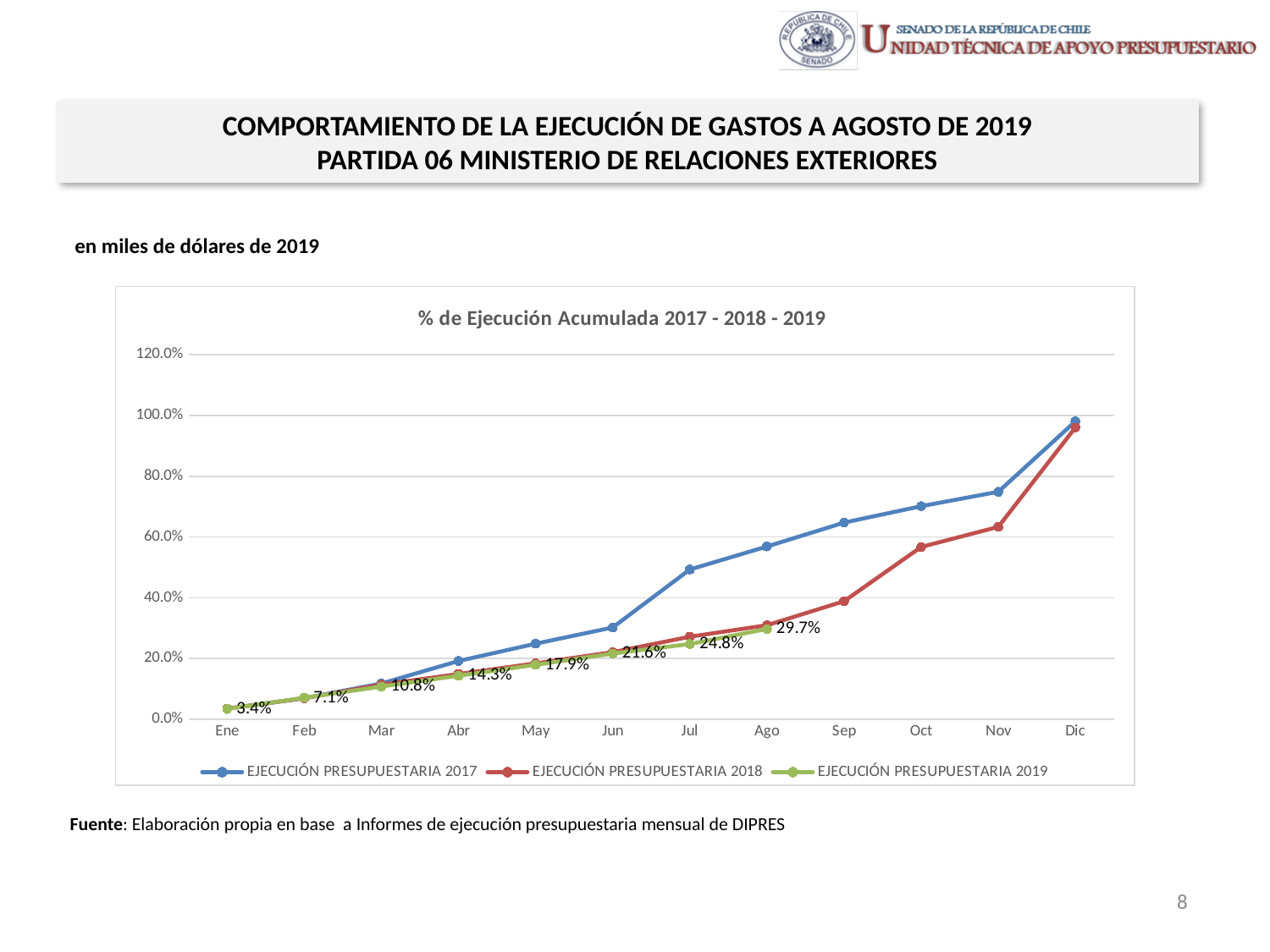
What is the value for EJECUCIÓN PRESUPUESTARIA 2019 in May? 17.9% What is the value for EJECUCIÓN PRESUPUESTARIA 2019 in Ene? 3.4% Is the value for EJECUCIÓN PRESUPUESTARIA 2018 in Oct greater or less than 60.0%? less What is the value for EJECUCIÓN PRESUPUESTARIA 2019 in Ago? 29.7% Does the EJECUCIÓN PRESUPUESTARIA 2019 series rise or fall from Ene to Ago? rise What is the title of the chart? % de Ejecución Acumulada 2017 - 2018 - 2019 Is the value for EJECUCIÓN PRESUPUESTARIA 2017 in Jul greater or less than 40.0%? greater How many months are shown on the x axis? 12 How many series does the legend list? 3 What type of chart is shown on the slide? line chart Which series has the higher value in Nov, EJECUCIÓN PRESUPUESTARIA 2017 or EJECUCIÓN PRESUPUESTARIA 2018? EJECUCIÓN PRESUPUESTARIA 2017 What is the difference between the EJECUCIÓN PRESUPUESTARIA 2019 values for Ago and Jul? 4.9%